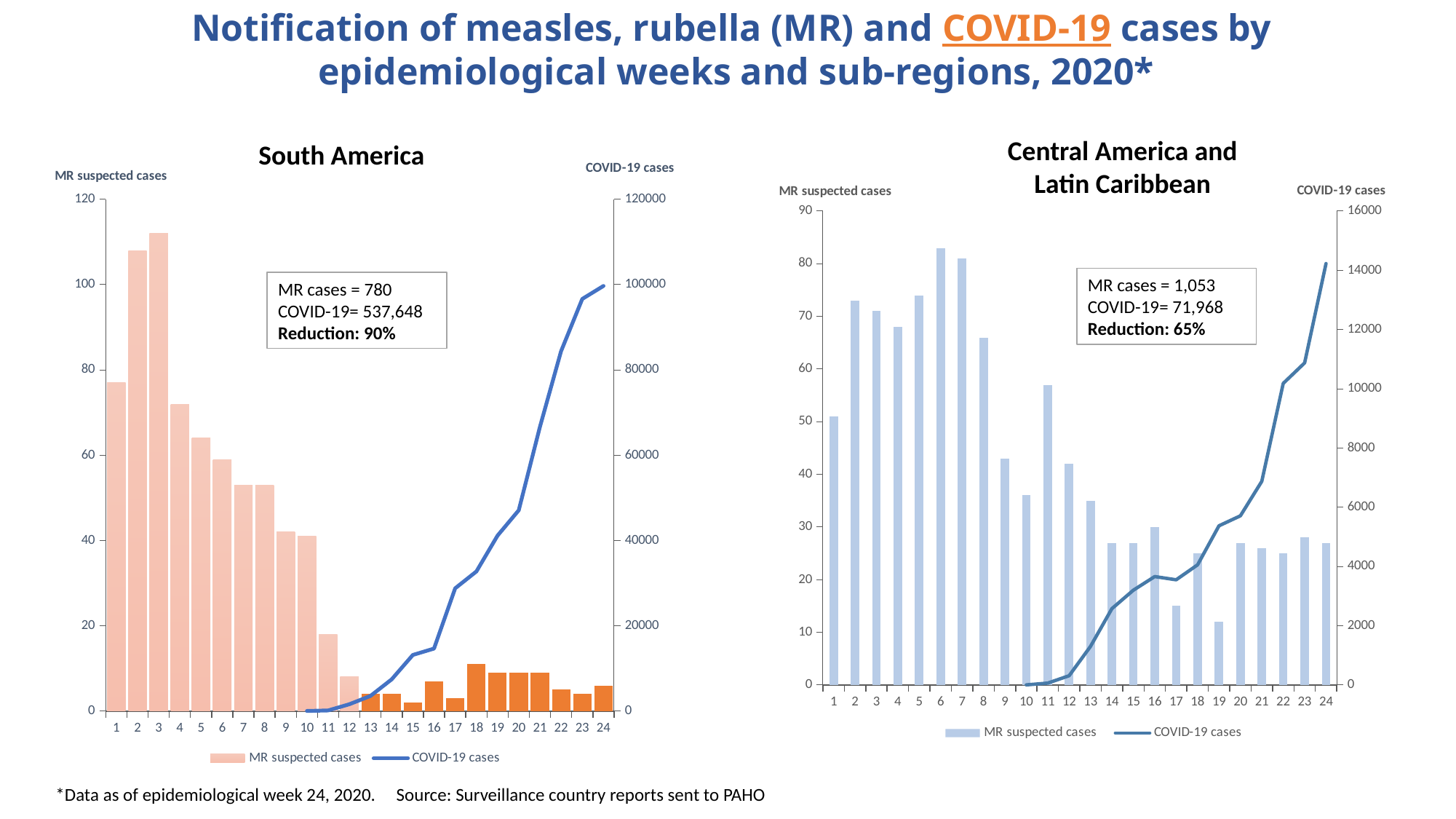
According to the text box in the Central America and Latin Caribbean chart, what is the reduction percentage? 65% In the Central America and Latin Caribbean chart, how many series does the legend list? 2 In the South America chart, is the number of MR suspected cases in week 11 greater or less than 20? less In the Central America and Latin Caribbean chart, which epidemiological week has the highest number of MR suspected cases? Week 6 In the South America chart, which epidemiological week has the highest number of MR suspected cases? Week 3 In the South America chart, are MR suspected cases higher in week 2 or in week 9? Week 2 In the South America chart, how many epidemiological weeks are shown on the x axis? 24 In the Central America and Latin Caribbean chart, which epidemiological week has the lowest number of MR suspected cases? Week 19 In the South America chart, is the number of MR suspected cases in week 1 greater or less than 60? greater According to the text box in the South America chart, what is the total number of COVID-19 cases? 537,648 In the South America chart, how do the COVID-19 cases change from week 10 to week 24? They rise In the Central America and Latin Caribbean chart, is the number of MR suspected cases in week 17 greater or less than 20? less